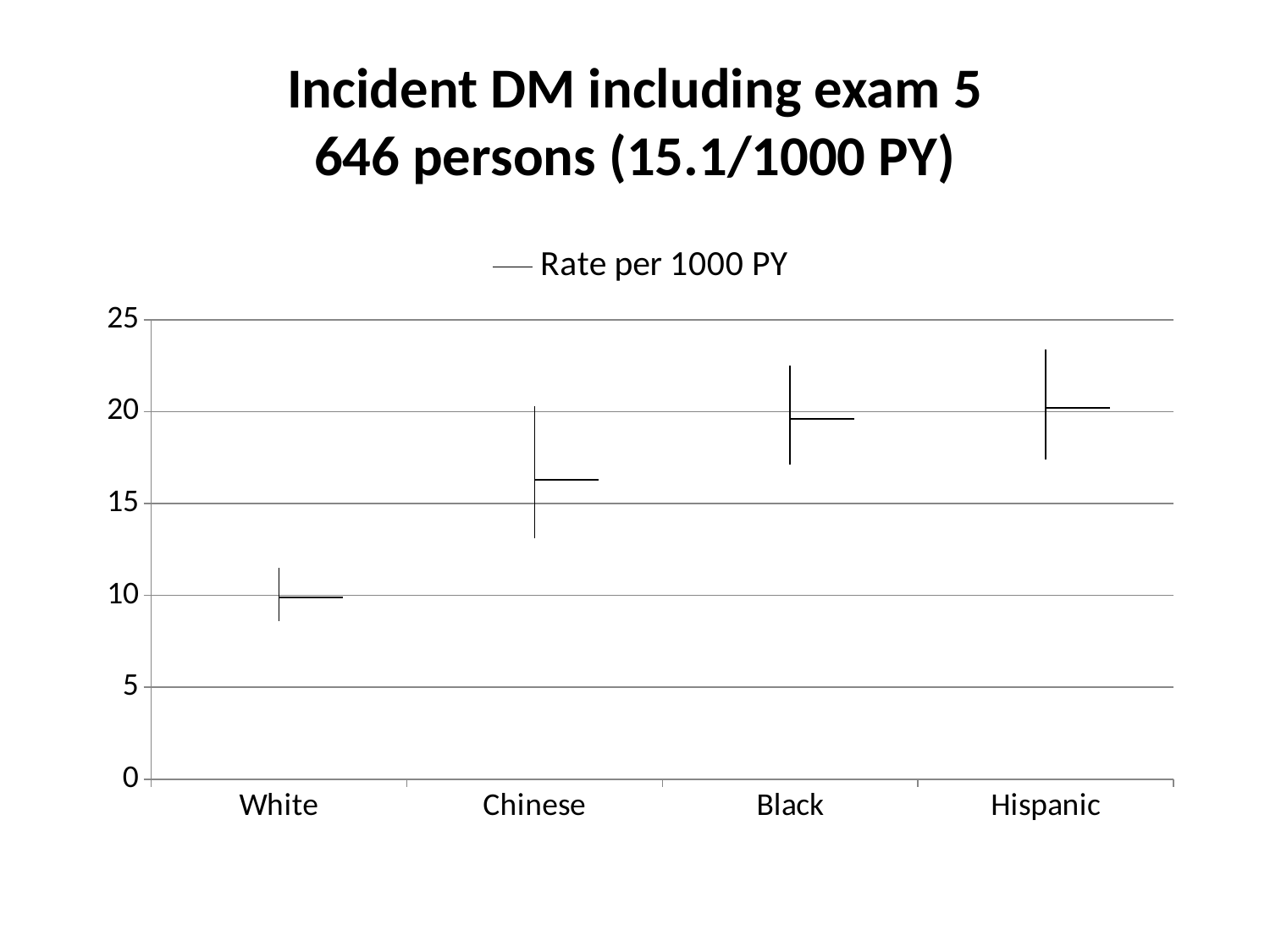
Is the value for Chinese greater or less than 15? greater Do the values rise or fall from White to Hispanic along the x axis? rise Is the value for White greater or less than 15? less Which has a higher rate per 1000 PY, Chinese or Black? Black What is the legend entry for the plotted series? Rate per 1000 PY Which has a higher rate per 1000 PY, White or Chinese? Chinese How many series does the legend list? 1 How many categories are shown on the x axis? 4 Is the value for Hispanic greater or less than 15? greater Which category has the lowest rate per 1000 PY? White